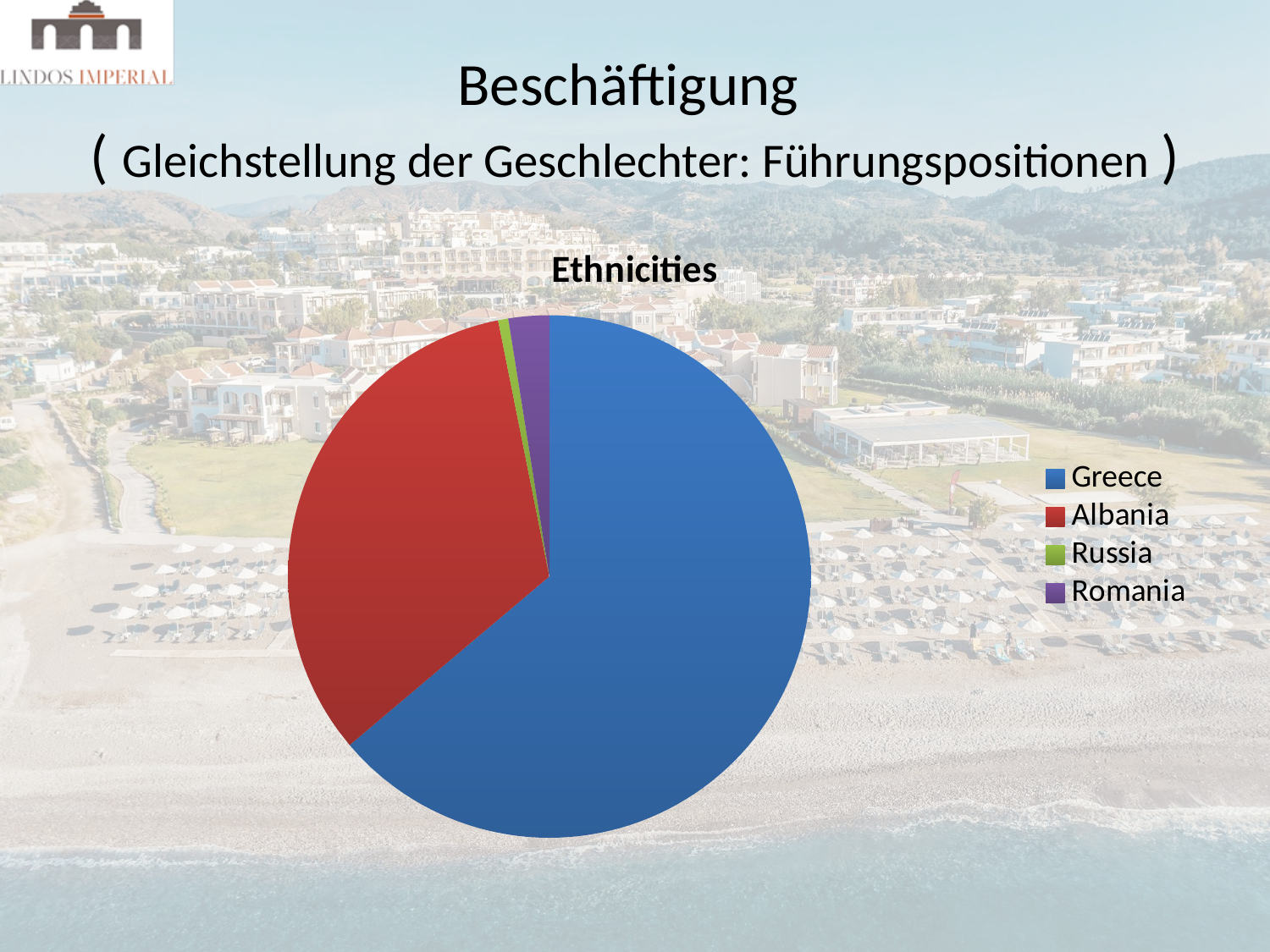
Which colour represents Albania in the pie chart? red What is the title of the chart? Ethnicities Which category has the smallest slice of the pie? Russia Which slice is larger, Greece or Albania? Greece Which category is listed second in the legend? Albania Which slice is larger, Romania or Russia? Romania Which slice is larger, Albania or Romania? Albania How many categories does the pie chart have? 4 Which category has the largest slice of the pie? Greece What kind of chart is shown on the slide? pie chart